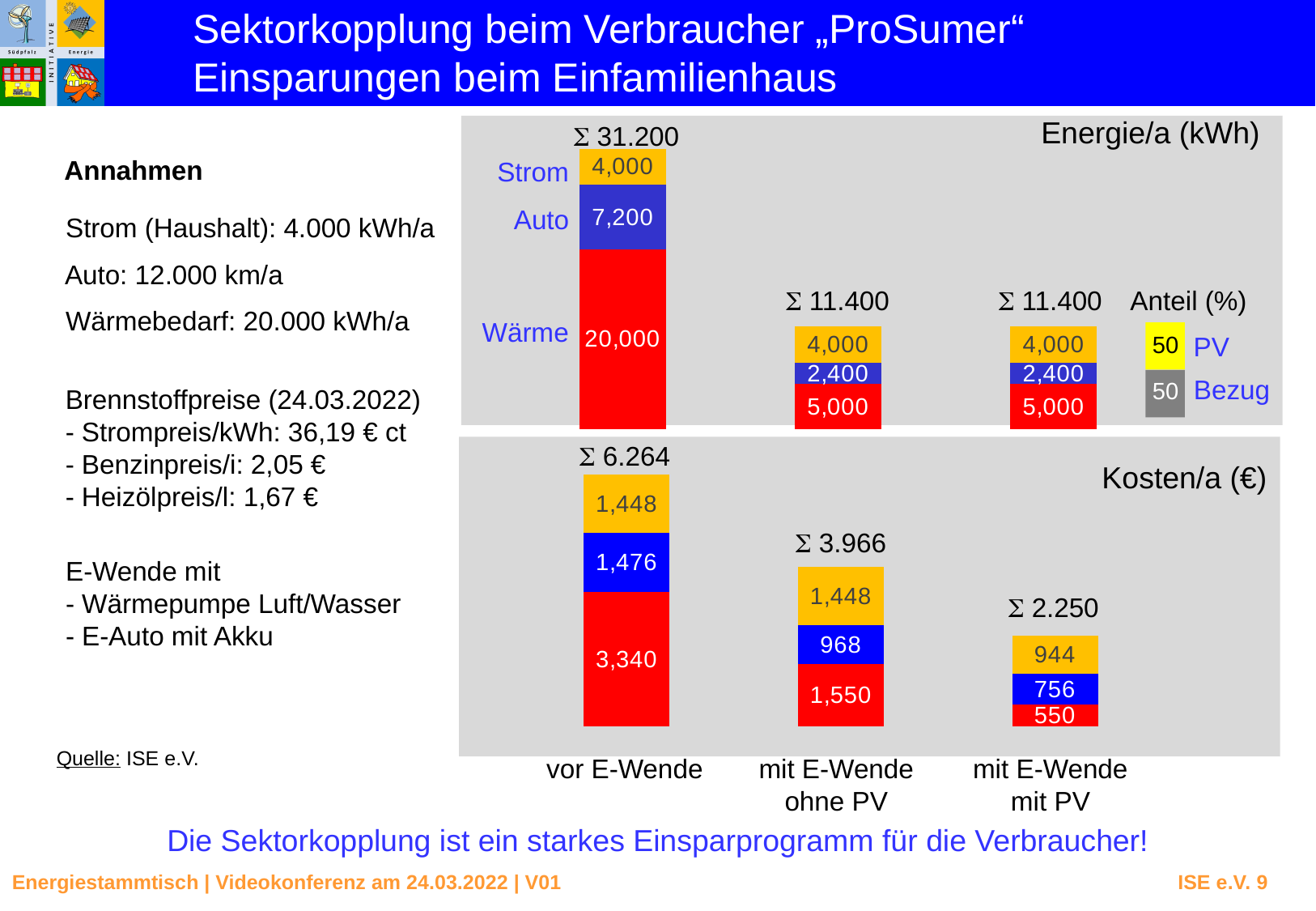
In the Energie/a (kWh) chart, what is the Wärme value for vor E-Wende? 20,000 In the Kosten/a (€) chart, what is the difference between the Wärme values for vor E-Wende and mit E-Wende ohne PV? 1,790 In the Kosten/a (€) chart, what is the Wärme value for mit E-Wende mit PV? 550 In the Kosten/a (€) chart, what is the total shown above the mit E-Wende mit PV bar? Σ 2.250 What type of chart is the Kosten/a (€) chart? stacked bar chart In the Energie/a (kWh) chart, what is the Auto value for mit E-Wende ohne PV? 2,400 In the Kosten/a (€) chart, which category has the highest total? vor E-Wende In the Energie/a (kWh) chart, what is the total shown above the vor E-Wende bar? Σ 31.200 In the Energie/a (kWh) chart, which series is shown in red? Wärme How many categories are shown along the x axis of the Kosten/a (€) chart? 3 In the Energie/a (kWh) chart, is the Auto value larger for vor E-Wende or for mit E-Wende mit PV? vor E-Wende In the Kosten/a (€) chart, what is the Auto value for mit E-Wende ohne PV? 968